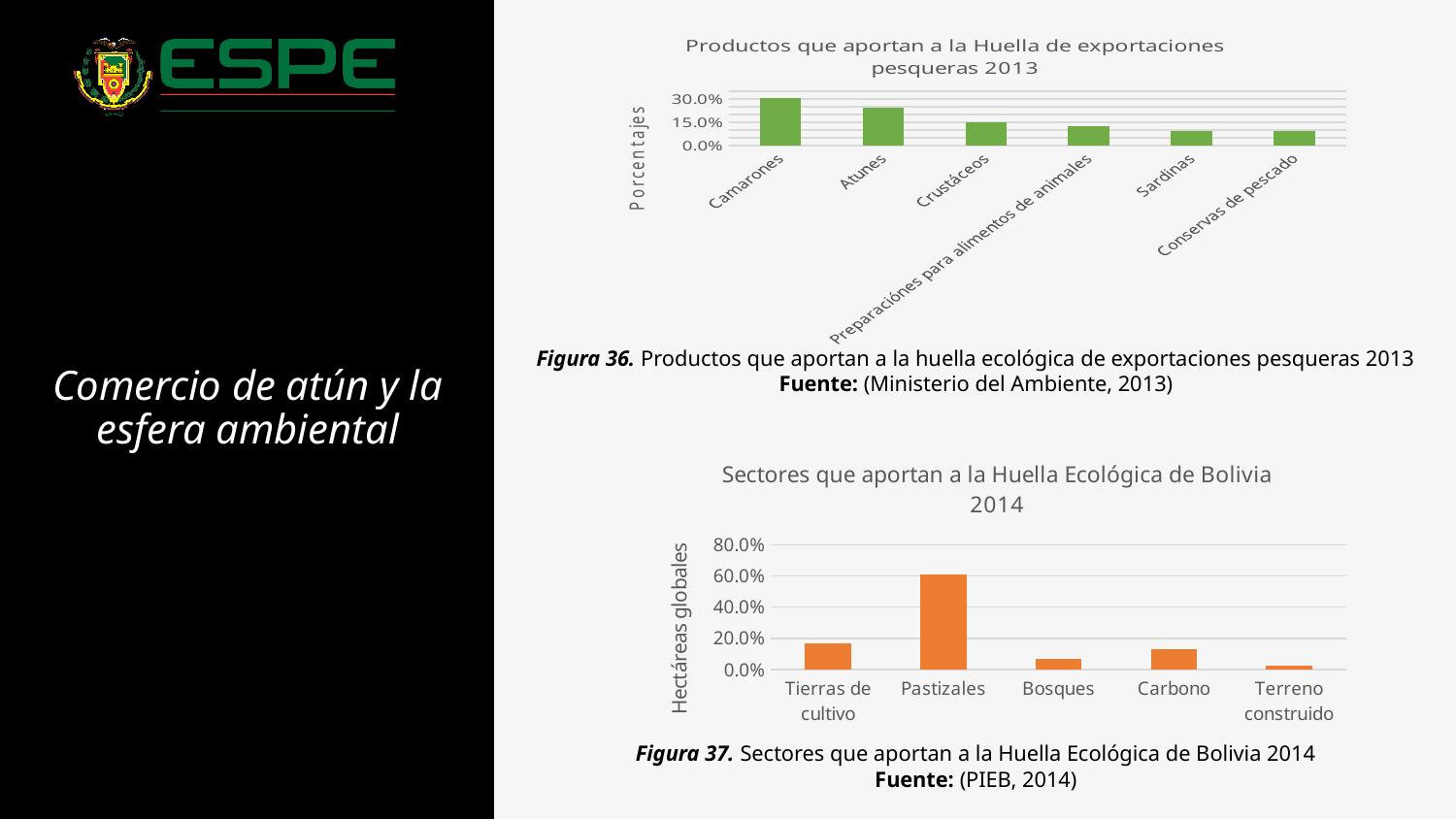
What kind of chart is the bottom chart, 'Sectores que aportan a la Huella Ecológica de Bolivia 2014'? Bar chart In the top chart 'Productos que aportan a la Huella de exportaciones pesqueras 2013', which product has the highest value? Camarones What is the y-axis label of the top chart 'Productos que aportan a la Huella de exportaciones pesqueras 2013'? Porcentajes In the bottom chart 'Sectores que aportan a la Huella Ecológica de Bolivia 2014', is the value for Pastizales greater or less than 40.0%? greater In the bottom chart 'Sectores que aportan a la Huella Ecológica de Bolivia 2014', which sector has the lowest value? Terreno construido What kind of chart is the top chart, 'Productos que aportan a la Huella de exportaciones pesqueras 2013'? Bar chart In the top chart 'Productos que aportan a la Huella de exportaciones pesqueras 2013', how many product categories are shown? 6 In the bottom chart 'Sectores que aportan a la Huella Ecológica de Bolivia 2014', which sector has the highest value? Pastizales In the top chart 'Productos que aportan a la Huella de exportaciones pesqueras 2013', is the value for Atunes greater or less than 15.0%? greater In the bottom chart 'Sectores que aportan a la Huella Ecológica de Bolivia 2014', how many sectors are shown? 5 In the top chart 'Productos que aportan a la Huella de exportaciones pesqueras 2013', is the value for Sardinas greater or less than 15.0%? less In the top chart 'Productos que aportan a la Huella de exportaciones pesqueras 2013', which is larger, the value for Camarones or the value for Crustáceos? Camarones